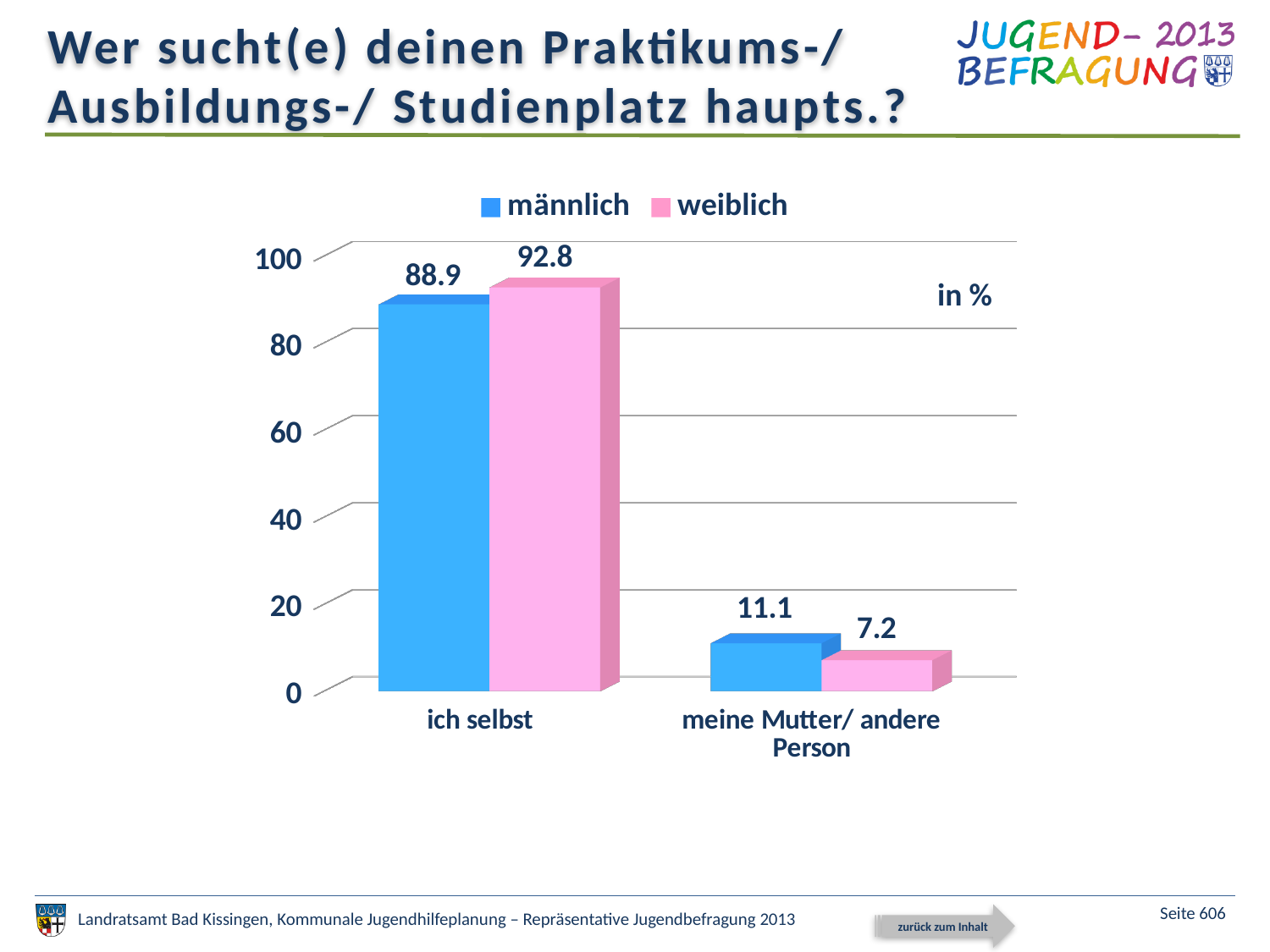
Which category has the highest value for weiblich? ich selbst What is the value for weiblich in the category 'meine Mutter/ andere Person'? 7.2 How many series does the legend list? 2 What is the difference between the männlich and weiblich values for 'meine Mutter/ andere Person'? 3.9 What is the difference between the weiblich and männlich values for 'ich selbst'? 3.9 What is the value for männlich in the category 'meine Mutter/ andere Person'? 11.1 Which is larger for 'meine Mutter/ andere Person': männlich or weiblich? männlich Which category has the lowest value for männlich? meine Mutter/ andere Person What kind of chart is shown on the slide? bar chart What is the value for weiblich in the category 'ich selbst'? 92.8 What is the value for männlich in the category 'ich selbst'? 88.9 How many categories are shown on the x axis? 2